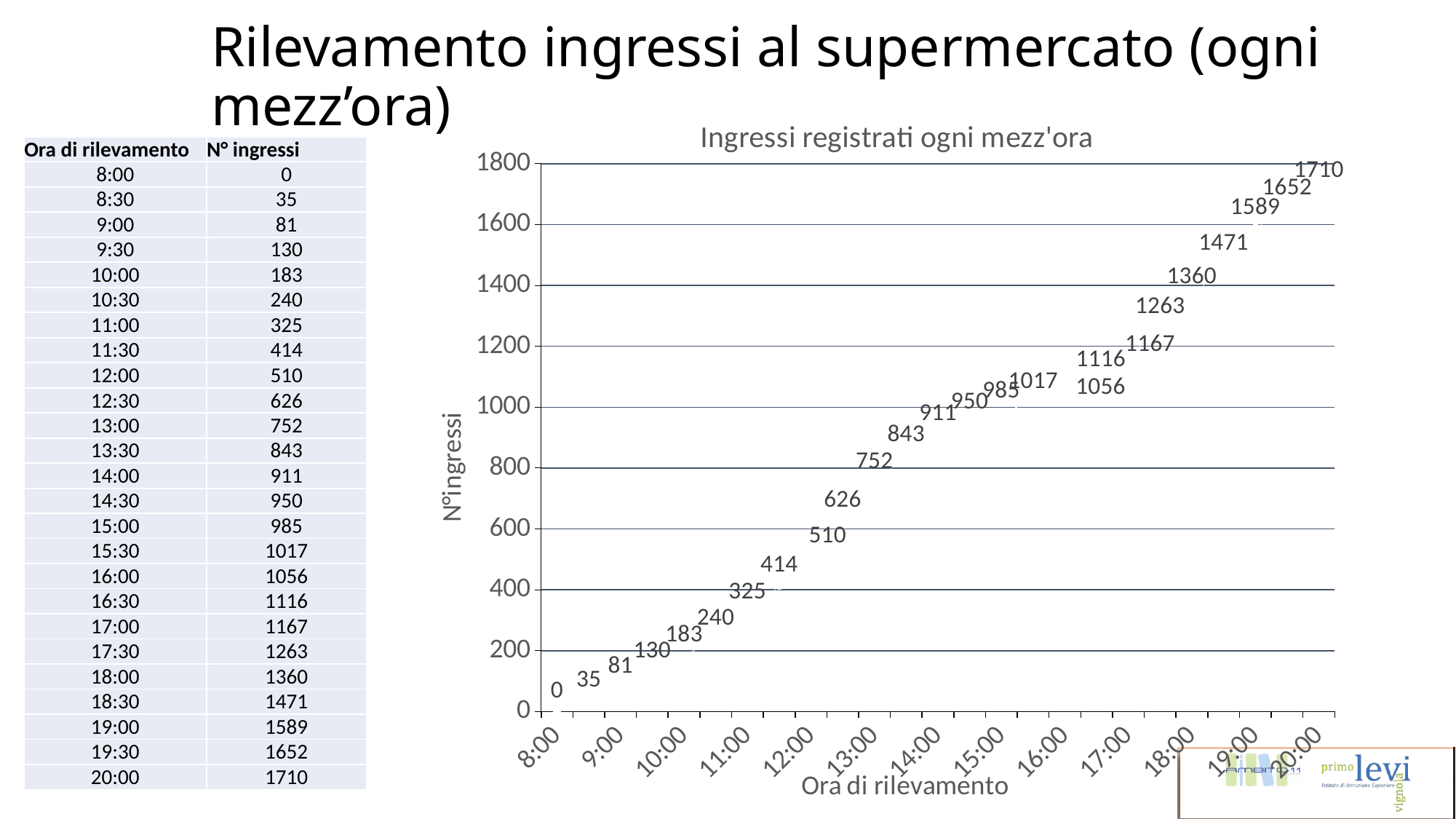
What is the title of the chart? Ingressi registrati ogni mezz'ora What is the label of the vertical axis of the chart? N°ingressi What is the difference between the entries at 20:00 and at 19:30? 58 What is the number of entries (N° ingressi) recorded at 12:00? 510 At which time is the number of entries highest? 20:00 Which time has more entries, 14:00 or 15:00? 15:00 Is the value for 16:00 greater or less than 1000? greater What is the number of entries recorded at 17:00? 1167 Do the values rise or fall as time moves from 8:00 to 20:00? rise What is the difference between the entries at 13:00 and at 12:30? 126 At which time is the number of entries lowest? 8:00 How many data points are plotted in the chart? 25